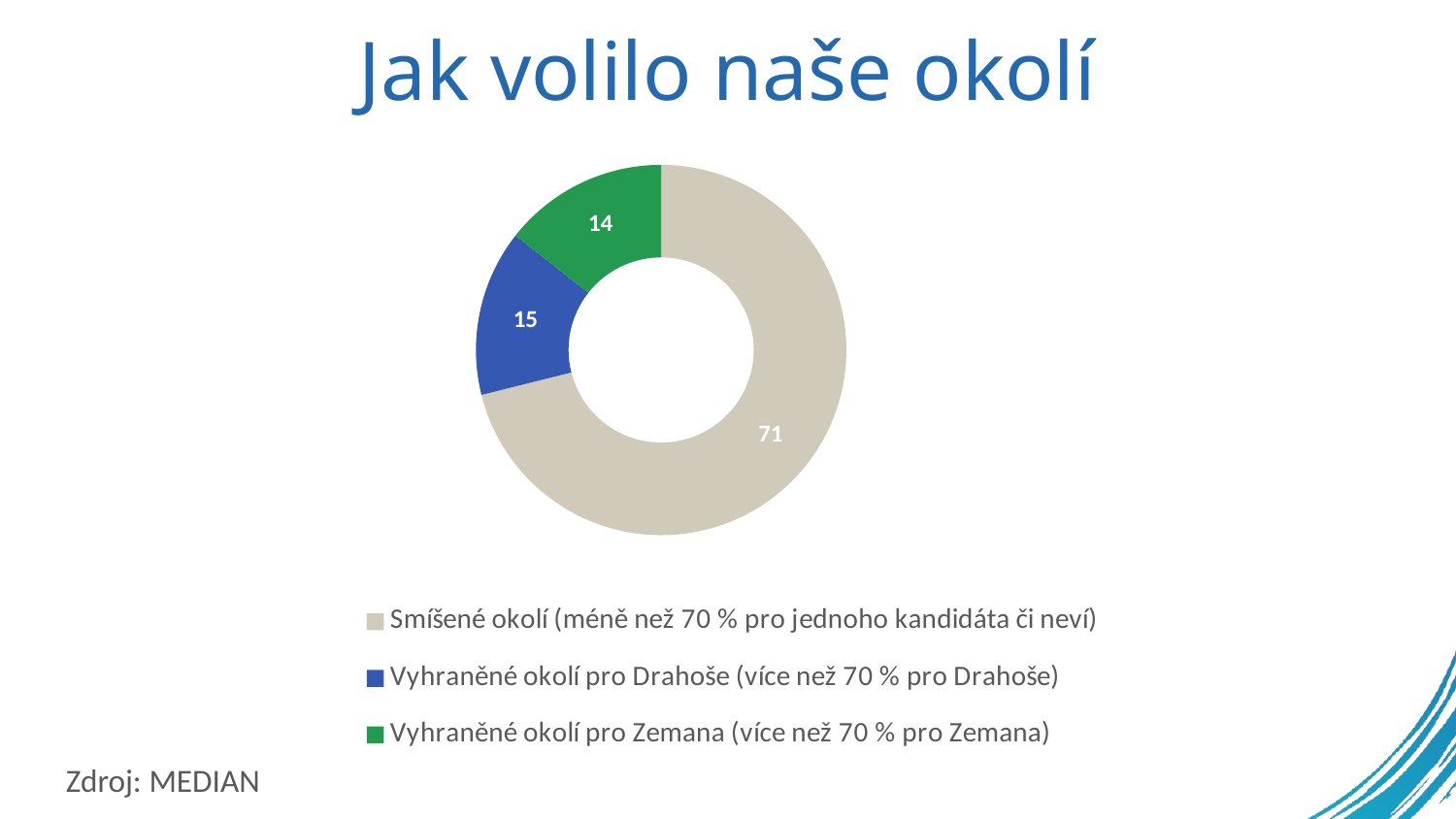
What is the value for Vyhraněné okolí pro Zemana (více než 70 % pro Zemana)? 14 Which is larger: the value for Vyhraněné okolí pro Drahoše or the value for Vyhraněné okolí pro Zemana? Vyhraněné okolí pro Drahoše What is the value for Vyhraněné okolí pro Drahoše (více než 70 % pro Drahoše)? 15 What is the difference between the value for Vyhraněné okolí pro Drahoše and the value for Vyhraněné okolí pro Zemana? 1 What is the value for Smíšené okolí (méně než 70 % pro jednoho kandidáta či neví)? 71 Which category has the smallest slice? Vyhraněné okolí pro Zemana (více než 70 % pro Zemana) What share of the total does the Smíšené okolí slice represent? 71% What is the title of the chart? Jak volilo naše okolí What kind of chart is shown on the slide? Doughnut chart How many categories does the chart show? 3 Which category has the largest slice? Smíšené okolí (méně než 70 % pro jednoho kandidáta či neví) What is the difference between the value for Smíšené okolí and the value for Vyhraněné okolí pro Drahoše? 56